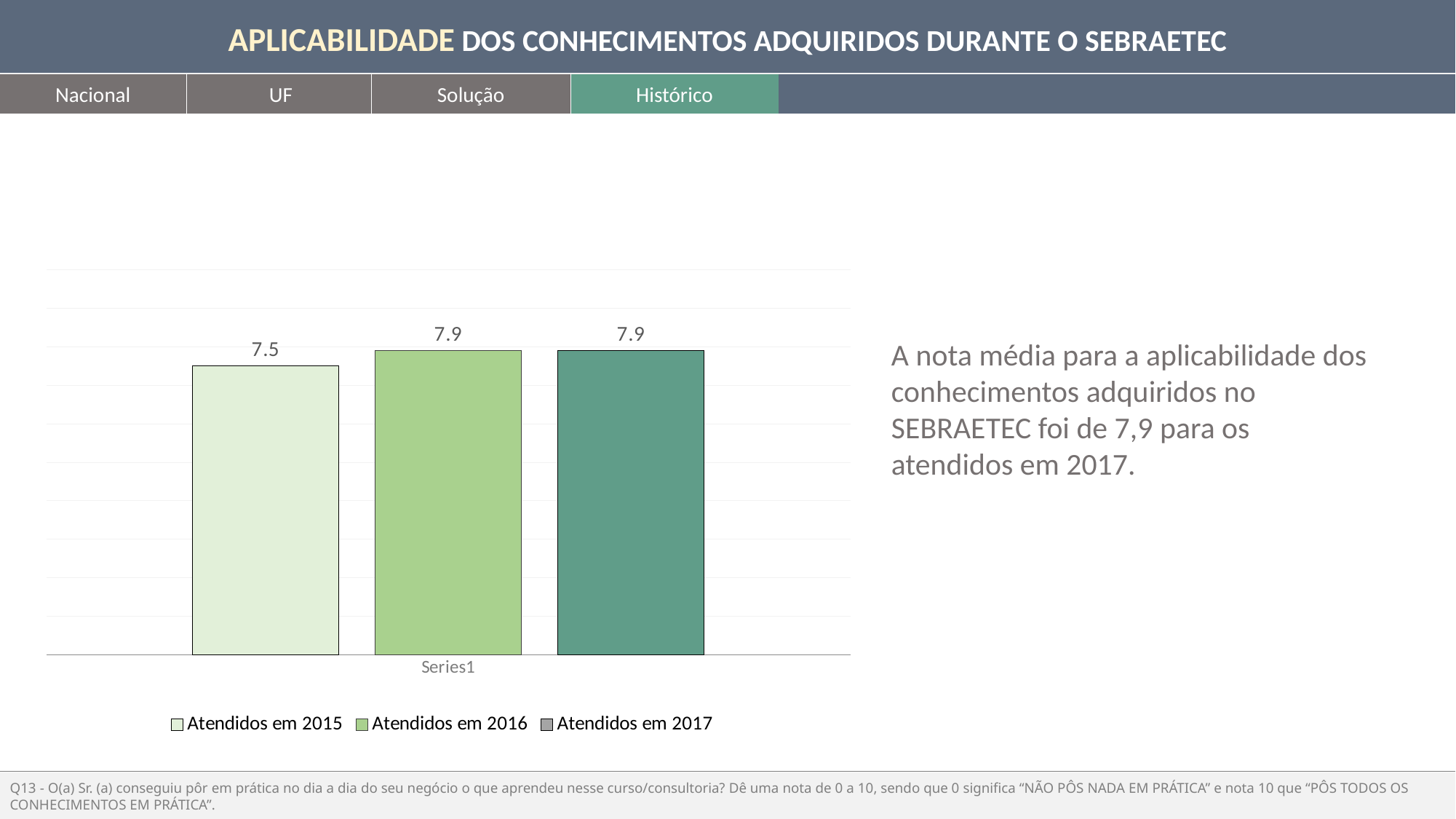
What kind of chart is shown on the slide? Bar chart What is the value for Atendidos em 2017? 7.9 How many series does the legend list? 3 What is the label shown on the x axis under the bars? Series1 What is the value for Atendidos em 2016? 7.9 Which series has the lowest value? Atendidos em 2015 What is the value for Atendidos em 2015? 7.5 Which series is drawn with the darkest green bar? Atendidos em 2017 Do the values rise or fall from Atendidos em 2015 to Atendidos em 2016? Rise Which is larger, the value for Atendidos em 2015 or Atendidos em 2017? Atendidos em 2017 How many bars are plotted in the chart? 3 What is the difference between the values for Atendidos em 2016 and Atendidos em 2015? 0.4